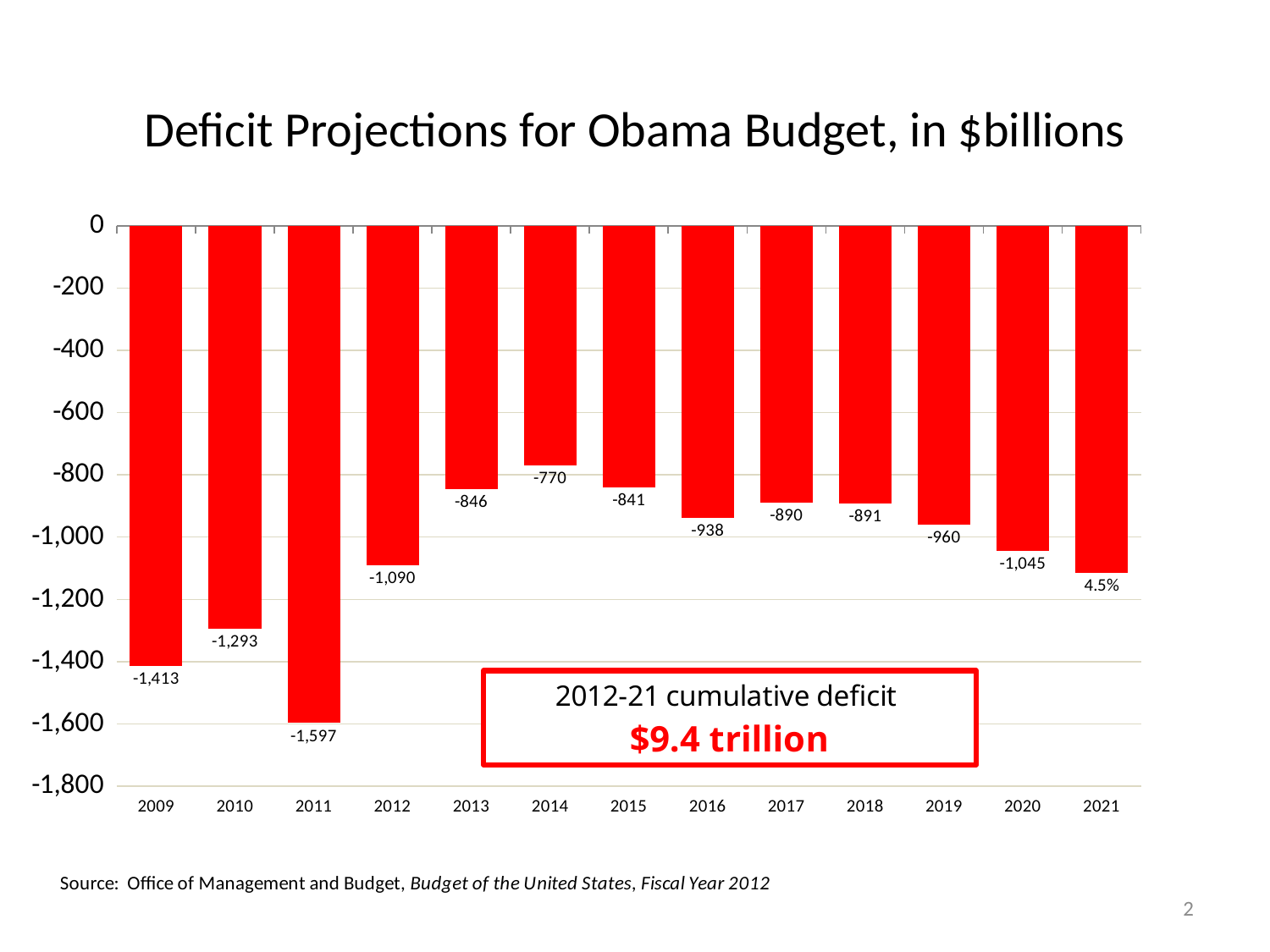
What is the difference between the 2012 and 2013 deficit values, in $billions? 244 What 2012-21 cumulative deficit is stated in the box on the chart? $9.4 trillion What is the deficit value shown for 2011? -1,597 What type of chart is shown on the slide? Bar chart What is the deficit value shown for 2009? -1,413 What is the deficit value shown for 2020? -1,045 Which year has the larger deficit, 2016 or 2019? 2019 What is the deficit value shown for 2014? -770 How many years are plotted on the chart? 13 Which year has the largest deficit (the lowest bar)? 2011 By how much does the deficit for 2009 exceed the deficit for 2010, in $billions? 120 Which year has the smallest deficit (the highest bar)? 2014